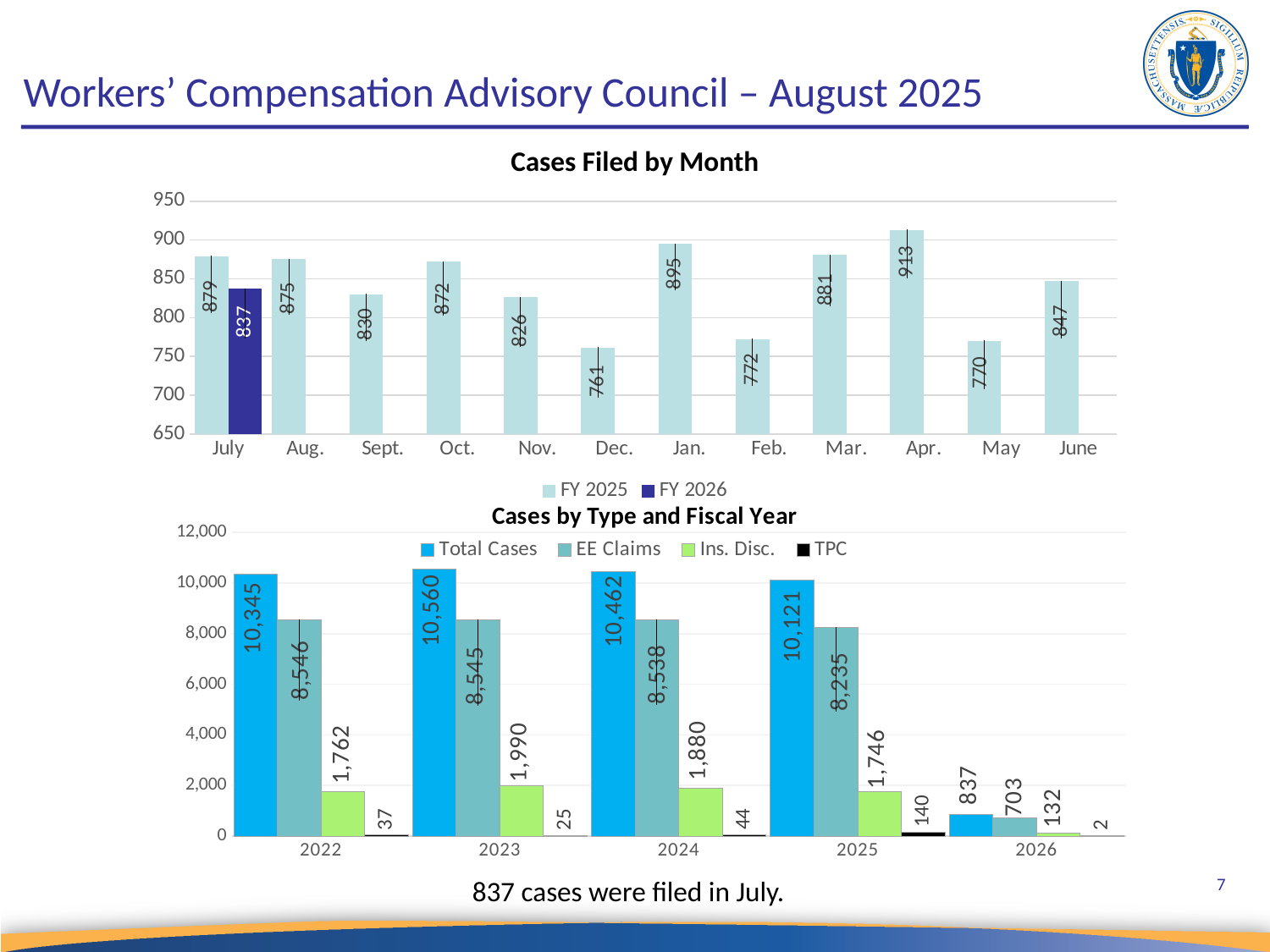
In the 'Cases by Type and Fiscal Year' chart, what is the Total Cases value for 2023? 10,560 In the 'Cases by Type and Fiscal Year' chart, what is the TPC value for 2025? 140 In the 'Cases Filed by Month' chart, which month has the lowest FY 2025 value? Dec. What kind of chart is 'Cases by Type and Fiscal Year'? Bar chart In the 'Cases by Type and Fiscal Year' chart, is the EE Claims value for 2024 or 2025 larger? 2024 In the 'Cases by Type and Fiscal Year' chart, how many fiscal years are shown on the x axis? 5 In the 'Cases Filed by Month' chart, what is the difference between the FY 2025 and FY 2026 values for July? 42 In the 'Cases Filed by Month' chart, which month has the highest FY 2025 value? Apr. In the 'Cases Filed by Month' chart, what is the FY 2025 value for Apr.? 913 In the 'Cases Filed by Month' chart, how many series does the legend list? 2 In the 'Cases Filed by Month' chart, what is the FY 2026 value for July? 837 In the 'Cases by Type and Fiscal Year' chart, which year has the highest Ins. Disc. value? 2023